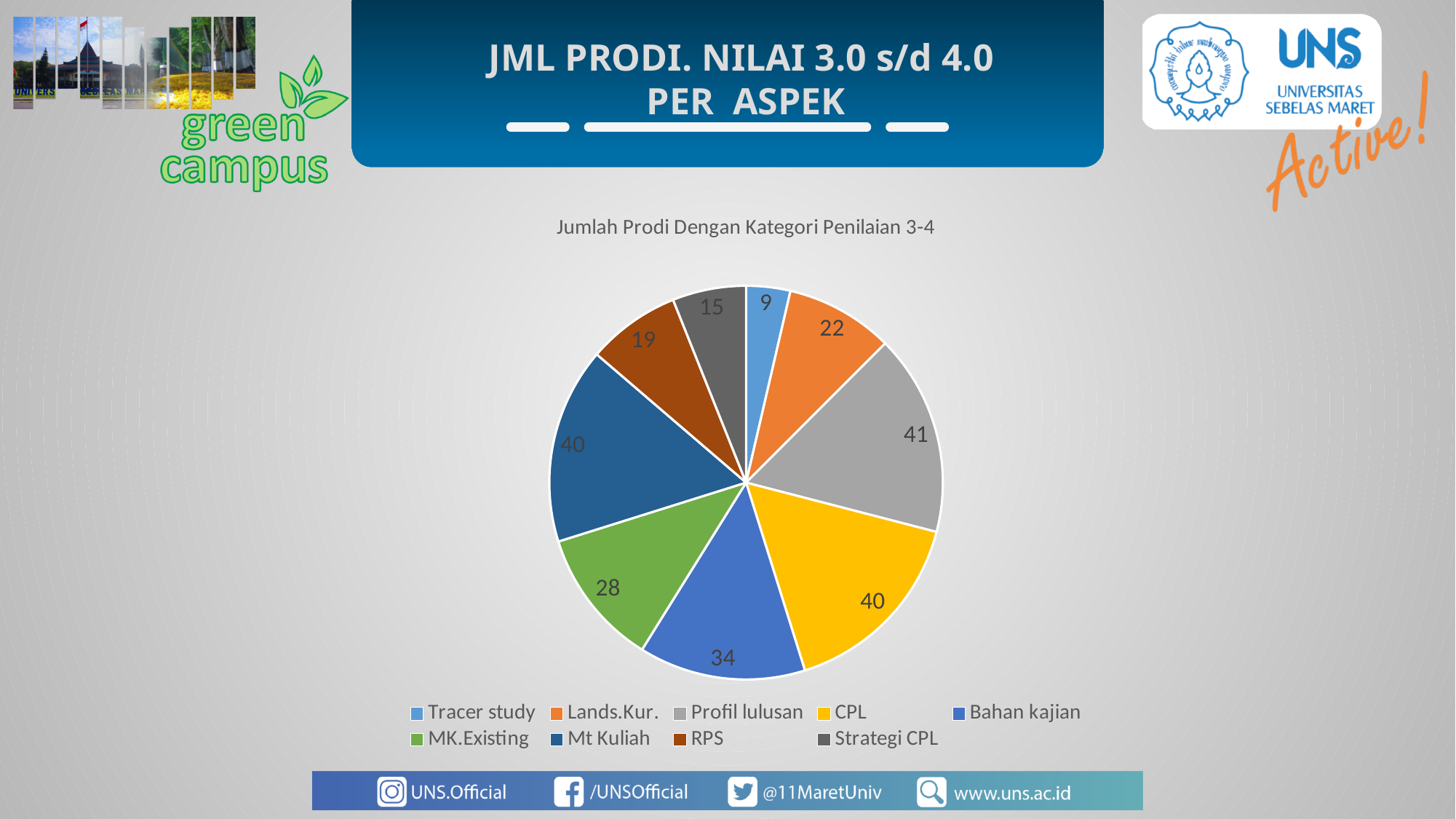
What is the value for Profil lulusan? 41 Which is larger, the value for Mt Kuliah or the value for Bahan kajian? Mt Kuliah What is the difference between the values for MK.Existing and Lands.Kur.? 6 Which category has the smallest slice? Tracer study What is the total of all the slice values in the pie chart? 248 What is the value for RPS? 19 What is the title of the chart? Jumlah Prodi Dengan Kategori Penilaian 3-4 What is the value for Strategi CPL? 15 What is the value for Bahan kajian? 34 Which category has the largest slice? Profil lulusan How many slices does the pie chart have? 9 What kind of chart is shown on the slide? pie chart